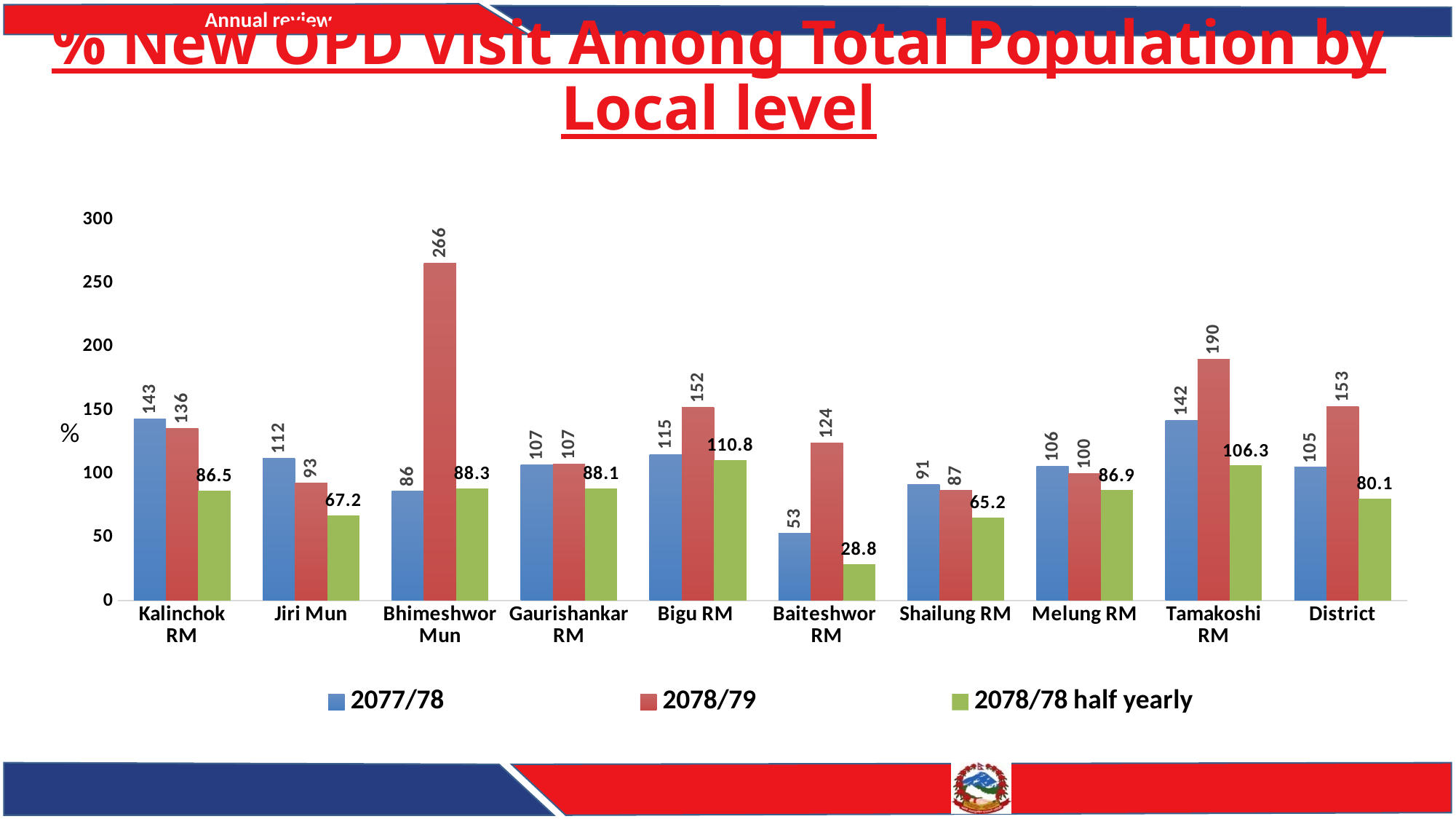
How many local levels are shown on the x axis? 10 What is the 2078/78 half yearly value for District? 80.1 What is the 2077/78 value for Tamakoshi RM? 142 Which local level has the lowest 2077/78 value? Baiteshwor RM What is the difference between the 2078/79 and 2077/78 values for Bhimeshwor Mun? 180 Which local level has the highest 2078/79 value? Bhimeshwor Mun What is the 2078/78 half yearly value for Baiteshwor RM? 28.8 Which is larger for Kalinchok RM, the 2077/78 value or the 2078/79 value? 2077/78 What kind of chart is shown on the slide? Bar chart How many series does the legend list? 3 Which colour represents the 2078/79 series? Red What is the 2078/79 value for Bhimeshwor Mun? 266